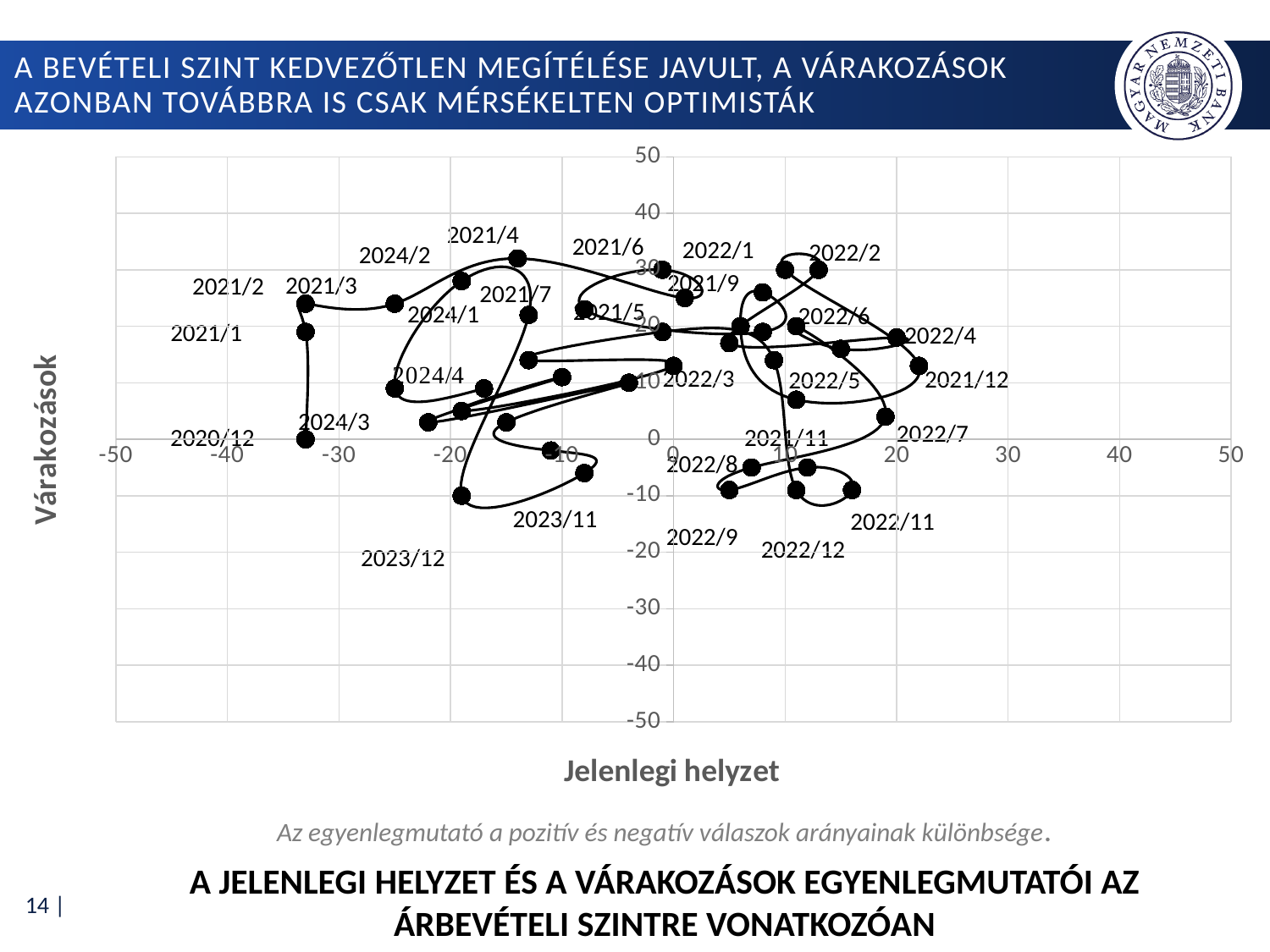
Is the Jelenlegi helyzet value for the point labelled 2021/12 greater or less than 10? greater What is the title of the vertical axis of the chart? Várakozások What is the title of the horizontal axis of the chart? Jelenlegi helyzet What kind of chart is shown on the slide? scatter chart Which point has the higher Várakozások value, 2021/4 or 2023/12? 2021/4 Which point has the higher Várakozások value, 2022/1 or 2022/11? 2022/1 Is the Várakozások value for the point labelled 2021/4 greater or less than 20? greater Is the Várakozások value for the point labelled 2022/9 greater or less than 0? less Which point has the higher Jelenlegi helyzet value, 2022/4 or 2021/1? 2022/4